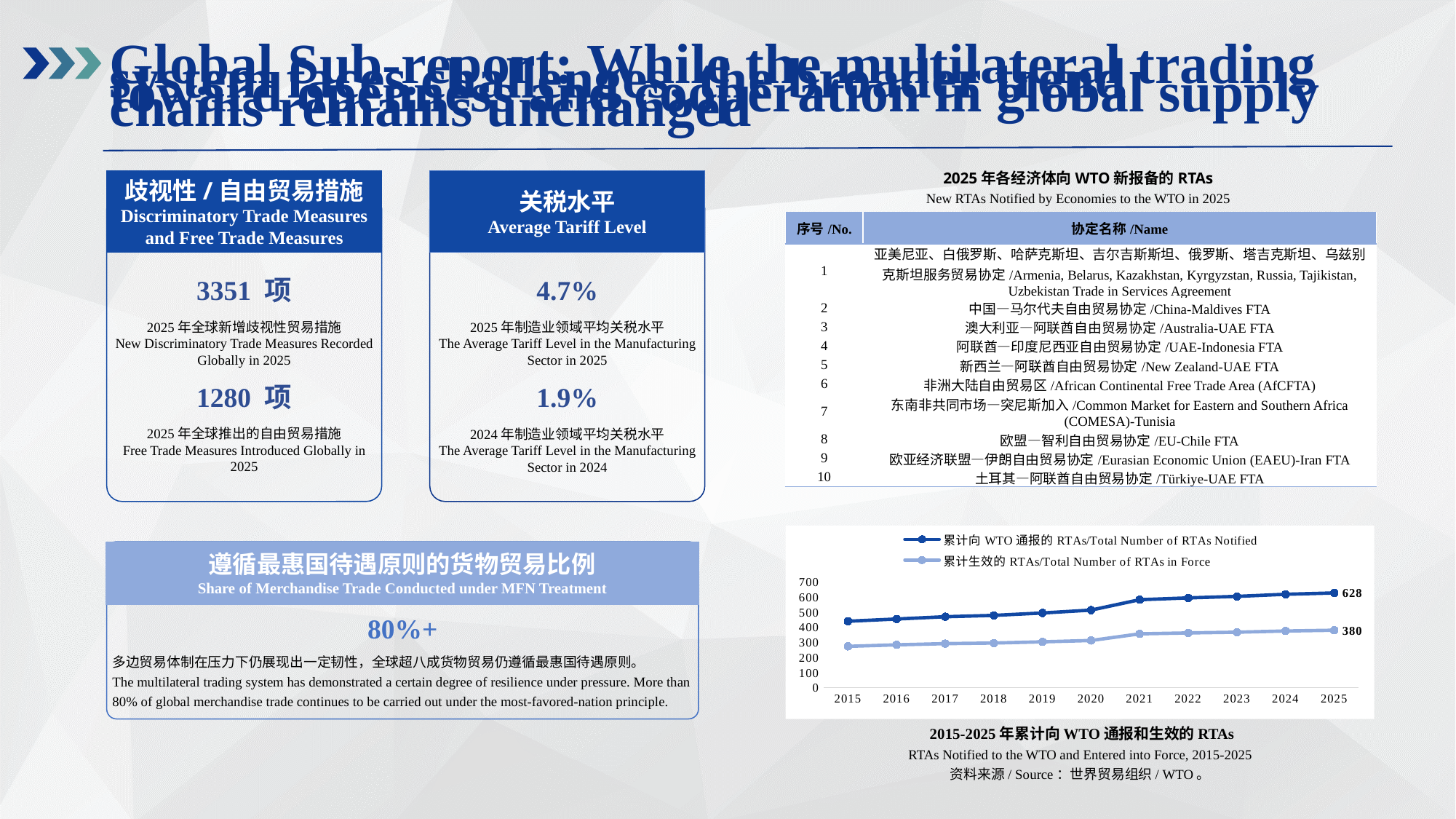
In the RTAs line chart, what is the difference between the Total Number of RTAs Notified and the Total Number of RTAs in Force in 2025? 248 In the RTAs line chart, does the Total Number of RTAs Notified rise or fall from 2015 to 2025? rise In the RTAs line chart, which year has the highest Total Number of RTAs Notified? 2025 In the RTAs line chart, what is the Total Number of RTAs in Force in 2025? 380 In the RTAs line chart, how many series does the legend list? 2 What type of chart is shown at the bottom right of the slide (RTAs Notified to the WTO and Entered into Force, 2015-2025)? line chart In the RTAs line chart, which series is higher in 2025: Total Number of RTAs Notified or Total Number of RTAs in Force? Total Number of RTAs Notified In the RTAs line chart, is the Total Number of RTAs in Force in 2015 greater or less than 300? less In the RTAs line chart, how many years are plotted along the x axis? 11 In the RTAs line chart, is the Total Number of RTAs Notified in 2021 greater or less than 500? greater In the RTAs line chart, what is the Total Number of RTAs Notified in 2025? 628 In the RTAs line chart, is the Total Number of RTAs Notified in 2015 greater or less than 500? less